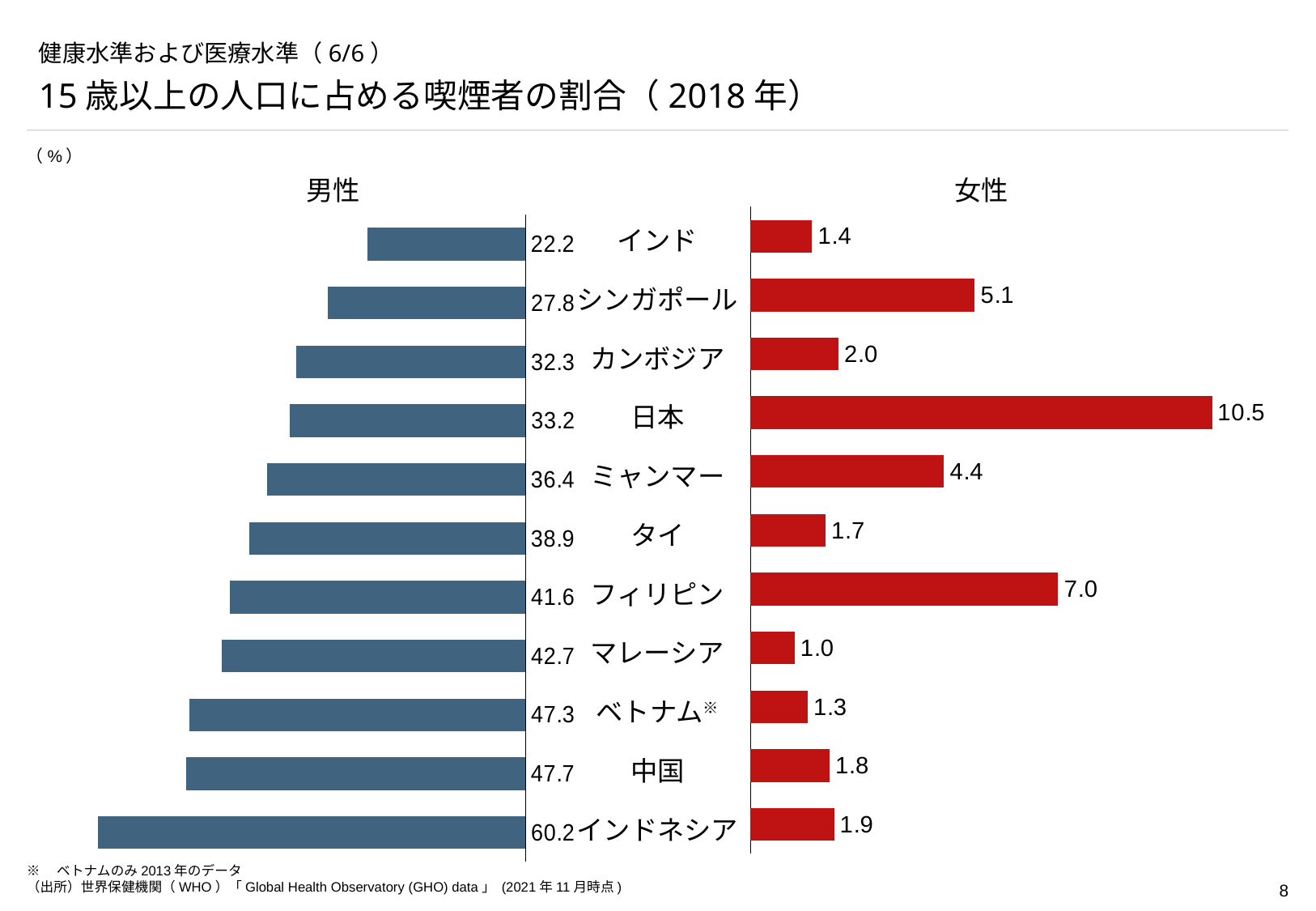
Which country has the lowest male smoking rate? インド What colour are the bars for 女性 (female)? red Which country has the highest male smoking rate? インドネシア What is the difference between the male and female smoking rates for 中国 (China)? 45.9 How many countries are shown in the chart? 11 Which country has the lowest female smoking rate? マレーシア Which is larger, the female smoking rate for シンガポール or for ミャンマー? シンガポール What is the female smoking rate for ベトナム (Vietnam)? 1.3 What kind of chart is shown on the slide? bar chart What is the female smoking rate for フィリピン (Philippines)? 7.0 What is the male smoking rate for 日本 (Japan)? 33.2 Which country has the highest female smoking rate? 日本